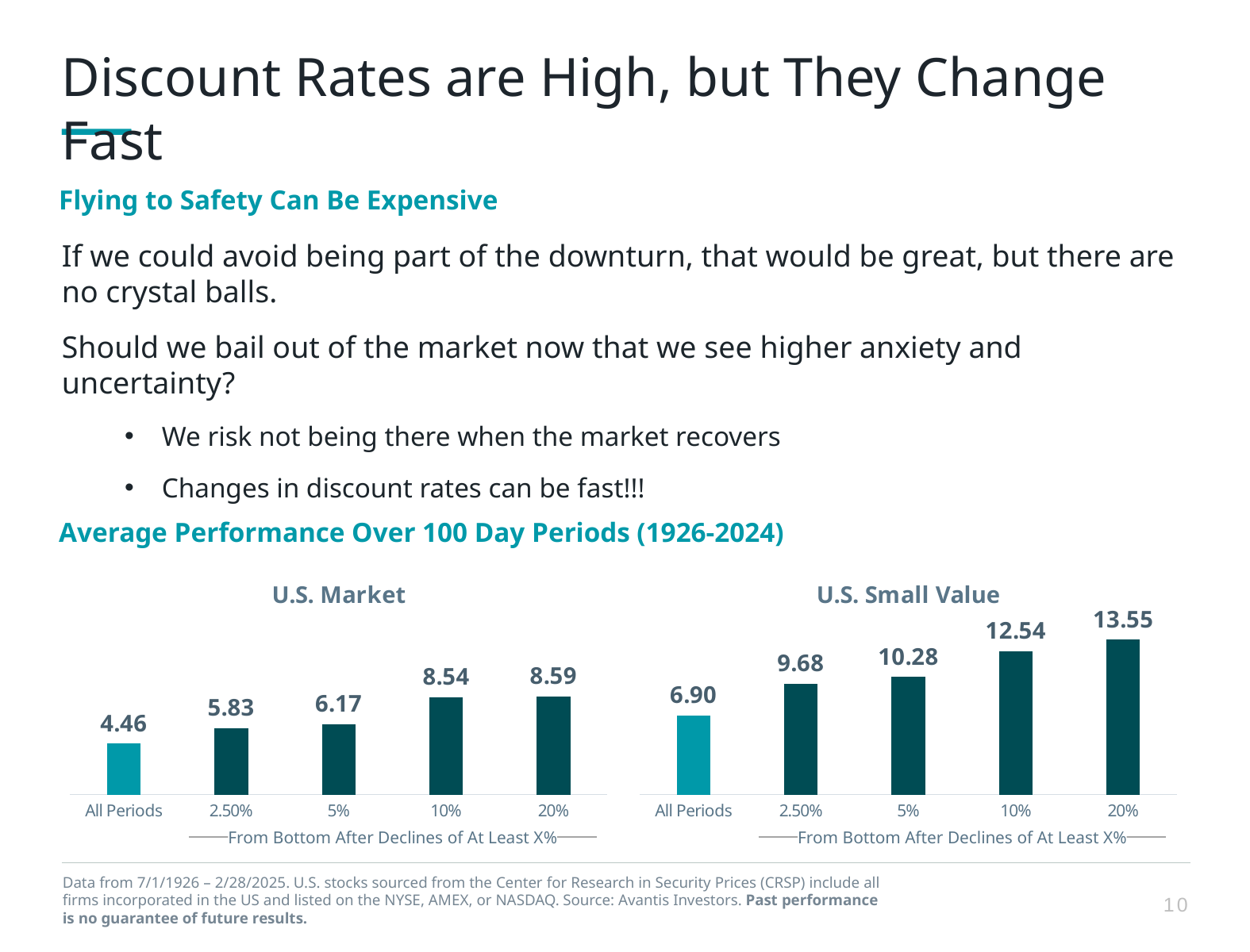
What kind of chart is the U.S. Small Value chart? Bar chart In the U.S. Small Value chart, what is the value for 10%? 12.54 How many categories are shown in the U.S. Market chart? 5 In the U.S. Small Value chart, which category has the highest value? 20% Which is larger: the All Periods value in the U.S. Market chart or the All Periods value in the U.S. Small Value chart? U.S. Small Value In the U.S. Market chart, what is the value for All Periods? 4.46 In the U.S. Market chart, what is the difference between the values for 10% and 2.50%? 2.71 In the U.S. Market chart, which category has the lowest value? All Periods In the U.S. Small Value chart, what is the difference between the values for 20% and All Periods? 6.65 In the U.S. Market chart, what is the value for 5%? 6.17 In the U.S. Small Value chart, do the values rise or fall from All Periods to 20%? Rise What is the x-axis label shown beneath the categories in the U.S. Market chart? From Bottom After Declines of At Least X%